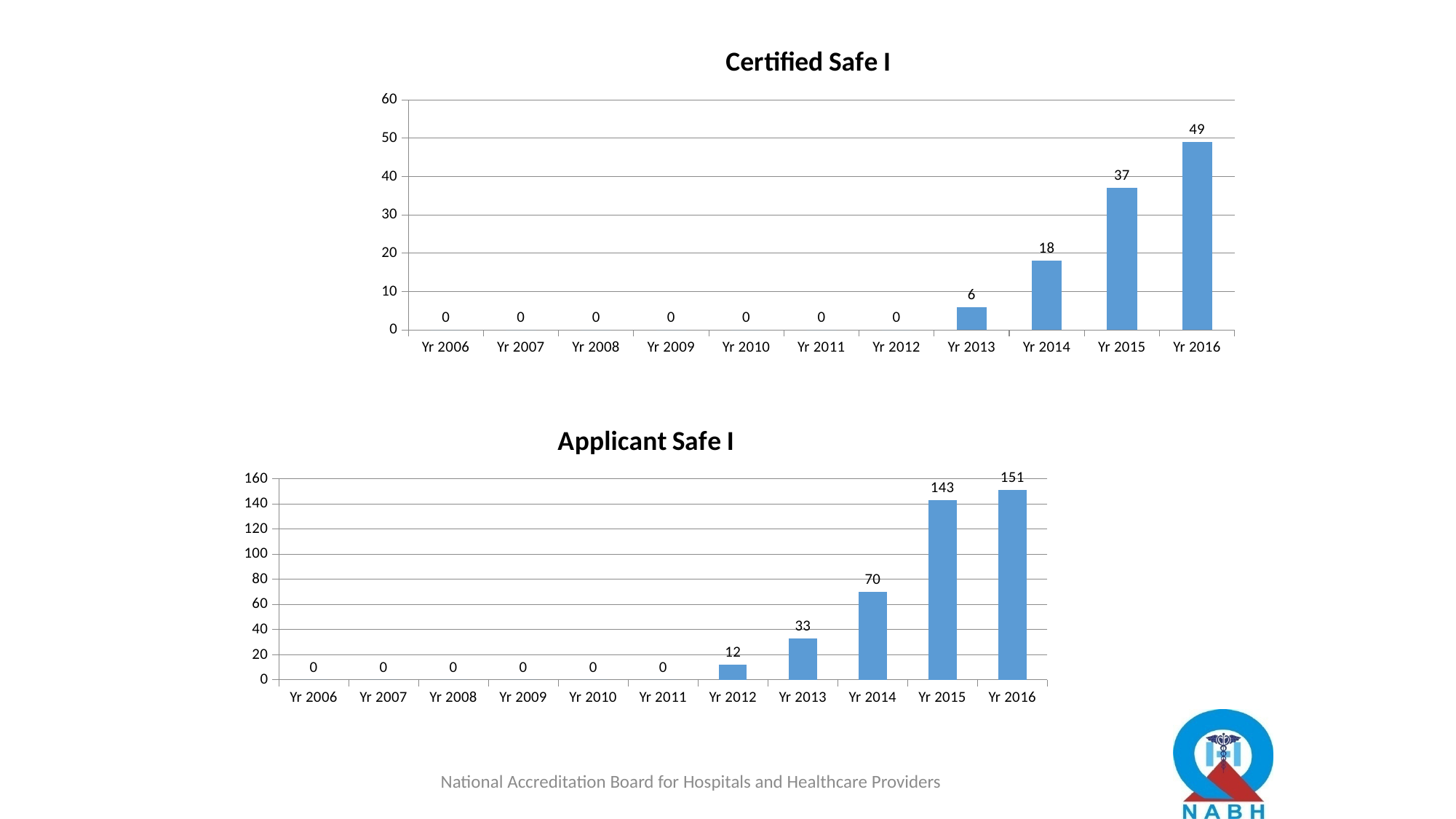
In the 'Certified Safe I' chart, which year has the highest value? Yr 2016 In the 'Applicant Safe I' chart, what is the value for Yr 2012? 12 In the 'Applicant Safe I' chart, what is the difference between the values for Yr 2015 and Yr 2014? 73 How many years are shown on the x axis of the 'Certified Safe I' chart? 11 In the 'Certified Safe I' chart, what is the value for Yr 2014? 18 In the 'Certified Safe I' chart, what is the value for Yr 2016? 49 In the 'Applicant Safe I' chart, which year has the highest value? Yr 2016 What kind of chart is the 'Applicant Safe I' chart? Bar chart In the 'Certified Safe I' chart, what is the difference between the values for Yr 2016 and Yr 2015? 12 In the 'Applicant Safe I' chart, which is larger, the value for Yr 2013 or the value for Yr 2014? Yr 2014 In the 'Certified Safe I' chart, do the values rise or fall from Yr 2013 to Yr 2016? Rise In the 'Applicant Safe I' chart, what is the value for Yr 2015? 143